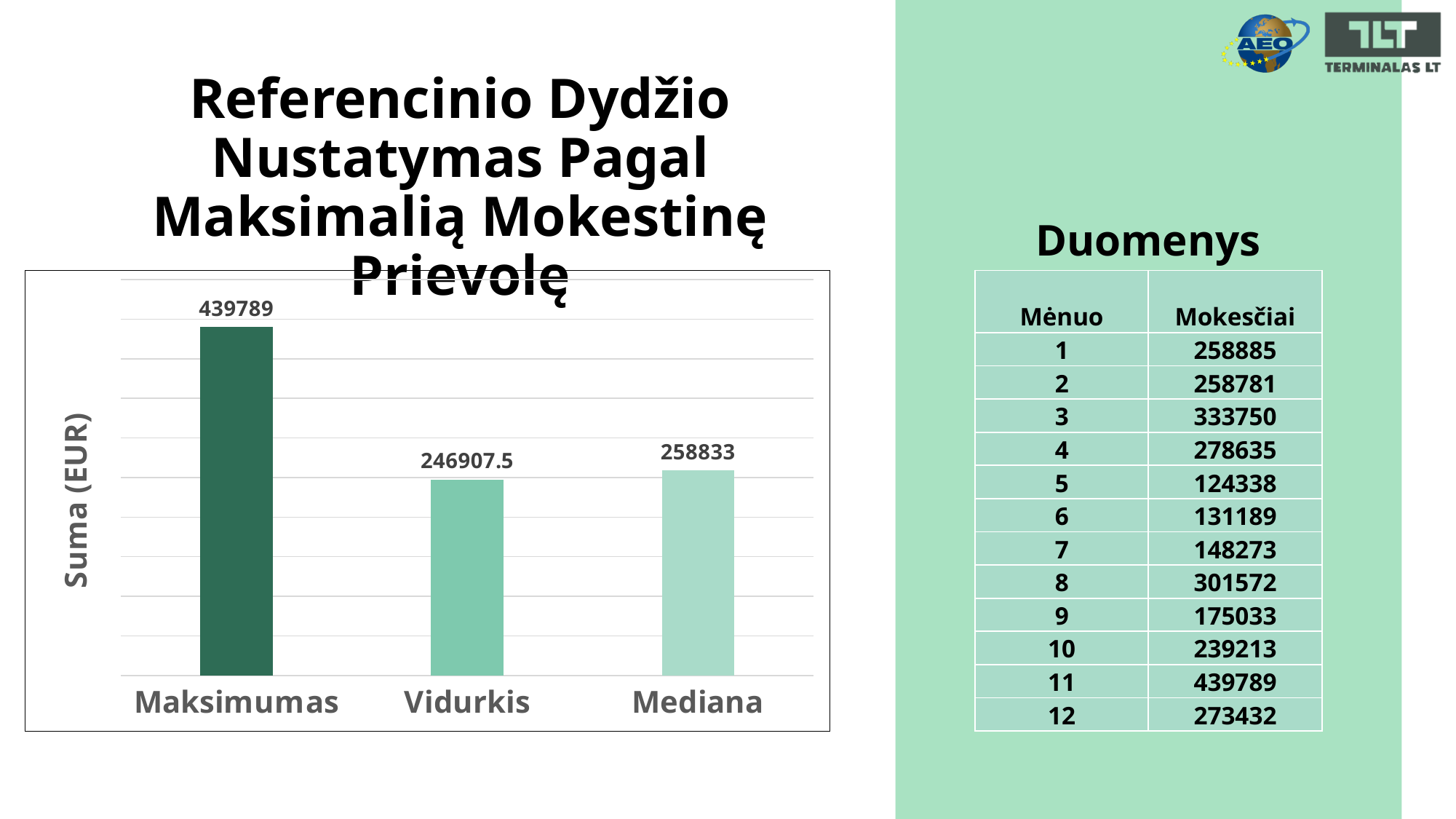
Which is larger, the Mediana value or the Vidurkis value? Mediana What is the label of the vertical axis of the chart? Suma (EUR) What is the value of the Vidurkis bar? 246907.5 What kind of chart is shown on the slide? Bar chart Which category has the lowest value in the chart? Vidurkis What is the difference between the Mediana and Vidurkis values? 11925.5 What is the difference between the Maksimumas and Mediana values? 180956 How many categories are shown in the chart? 3 What is the value of the Maksimumas bar? 439789 What is the value of the Mediana bar? 258833 What is the difference between the Maksimumas and Vidurkis values? 192881.5 Which category has the highest value in the chart? Maksimumas